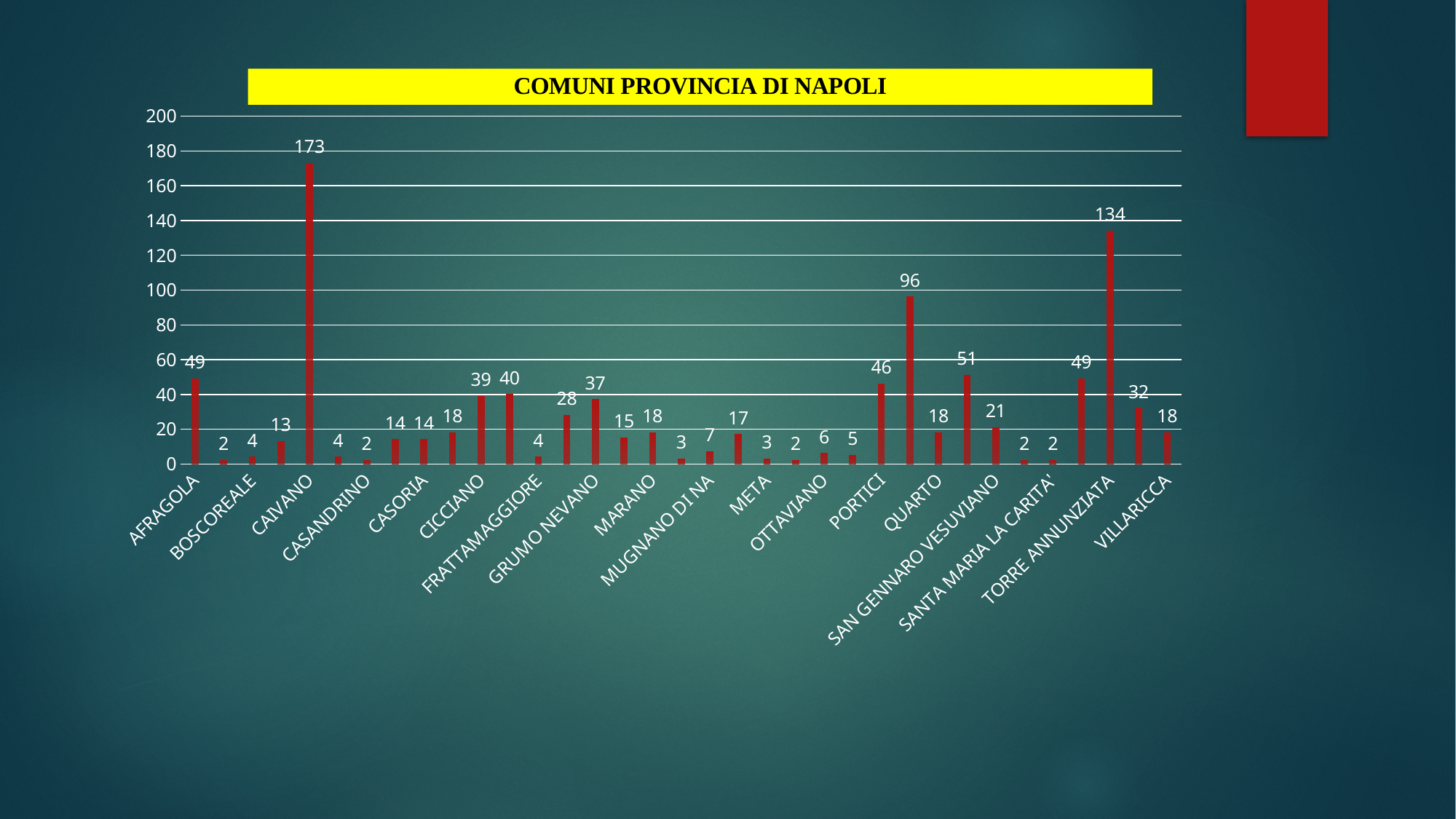
What is the value for PORTICI? 46 What is the value for CAIVANO? 173 What is the title of the chart? COMUNI PROVINCIA DI NAPOLI What is the value for CICCIANO? 39 Is the value for CAIVANO greater or less than 160? greater What is the value for GRUMO NEVANO? 37 What type of chart is shown on the slide? bar chart Which labelled comune has the highest value? CAIVANO What is the difference between the values for CAIVANO and TORRE ANNUNZIATA? 39 Which has a larger value, AFRAGOLA or PORTICI? AFRAGOLA What is the value for AFRAGOLA? 49 What is the value for TORRE ANNUNZIATA? 134